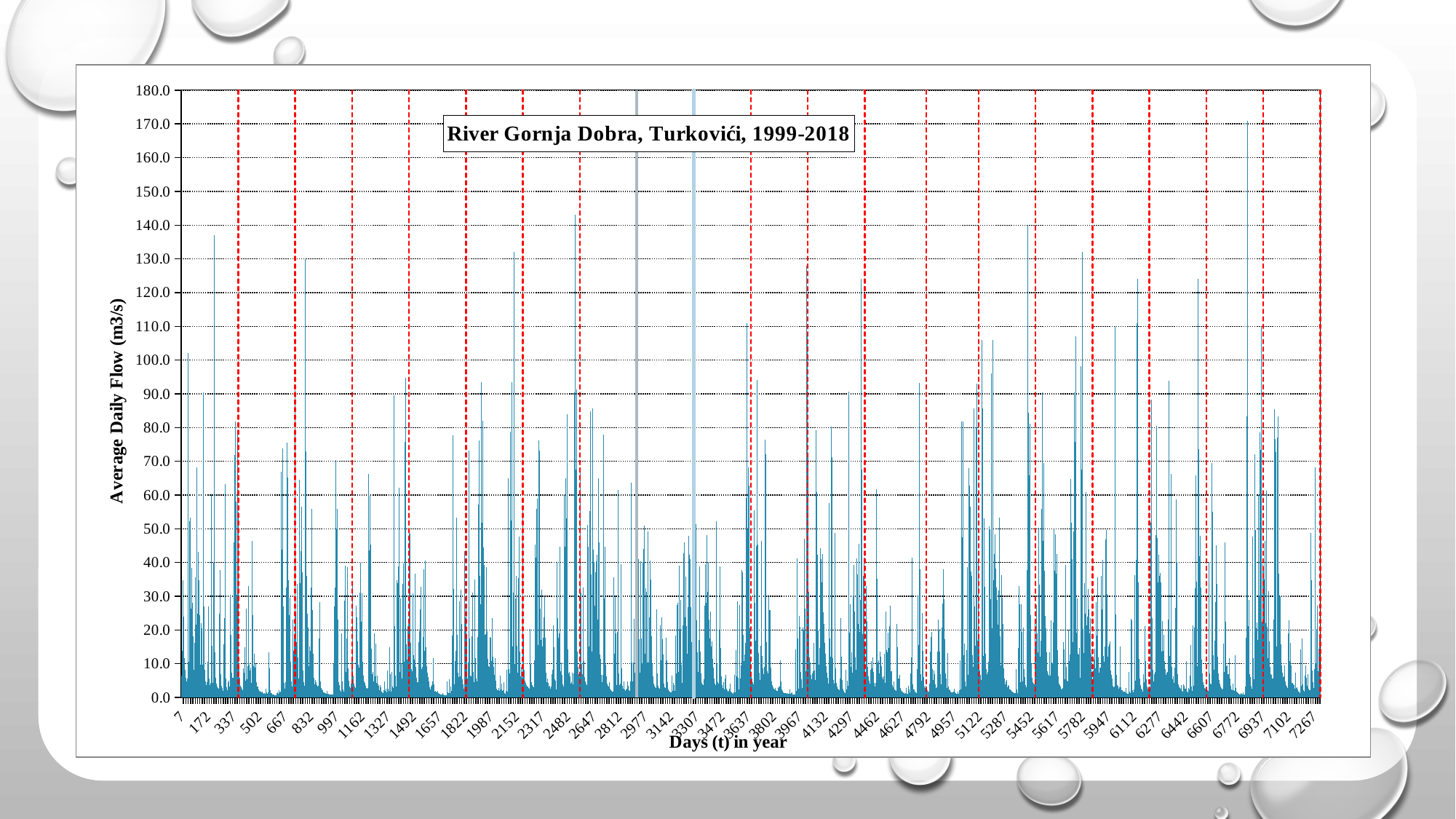
Is the peak flow near day 4627 greater or less than 50? less Is the peak flow near day 1162 greater or less than 100? less What is the last label on the horizontal axis? 7267 What is the title of the chart? River Gornja Dobra, Turkovići, 1999-2018 Is the peak flow near day 172 greater or less than 100? greater Around which horizontal-axis label does the highest peak of the whole series occur? 6772 What is the highest value shown on the vertical axis? 180.0 Which peak is higher: the one near day 172 or the one near day 1162? near day 172 What is the first label on the horizontal axis? 7 What is the label of the vertical axis? Average Daily Flow (m3/s)